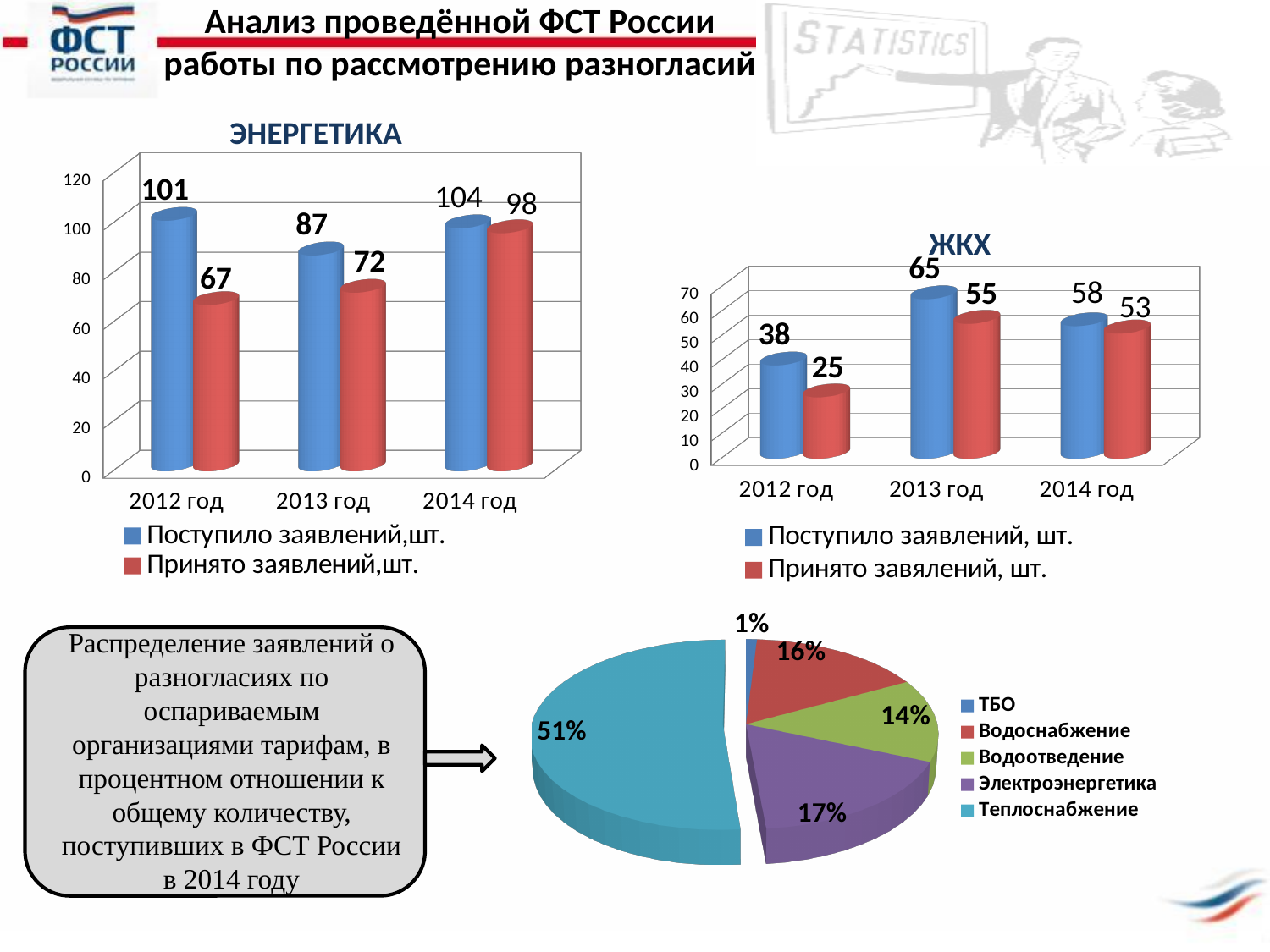
In the ЭНЕРГЕТИКА chart, what is the value of Поступило заявлений,шт. for 2013 год? 87 In the ЭНЕРГЕТИКА chart, what is the difference between Поступило заявлений,шт. and Принято заявлений,шт. in 2014 год? 6 In the ЖКХ chart, what is the difference between Поступило заявлений, шт. and Принято завялений, шт. in 2012 год? 13 In the ЖКХ chart, what is the value of Принято завялений, шт. for 2013 год? 55 In the ЖКХ chart, which year has the lowest value of Поступило заявлений, шт.? 2012 год In the pie chart at the bottom of the slide, which is larger: Водоснабжение or Электроэнергетика? Электроэнергетика In the ЭНЕРГЕТИКА chart, does the value of Принято заявлений,шт. rise or fall from 2012 год to 2014 год? rise In the pie chart at the bottom of the slide, which category has the smallest share? ТБО In the ЭНЕРГЕТИКА chart, which year has the highest value of Поступило заявлений,шт.? 2014 год In the ЭНЕРГЕТИКА chart, what is the value of Принято заявлений,шт. for 2012 год? 67 In the pie chart at the bottom of the slide, what share does Теплоснабжение have? 51% In the ЖКХ chart, how many series does the legend list? 2